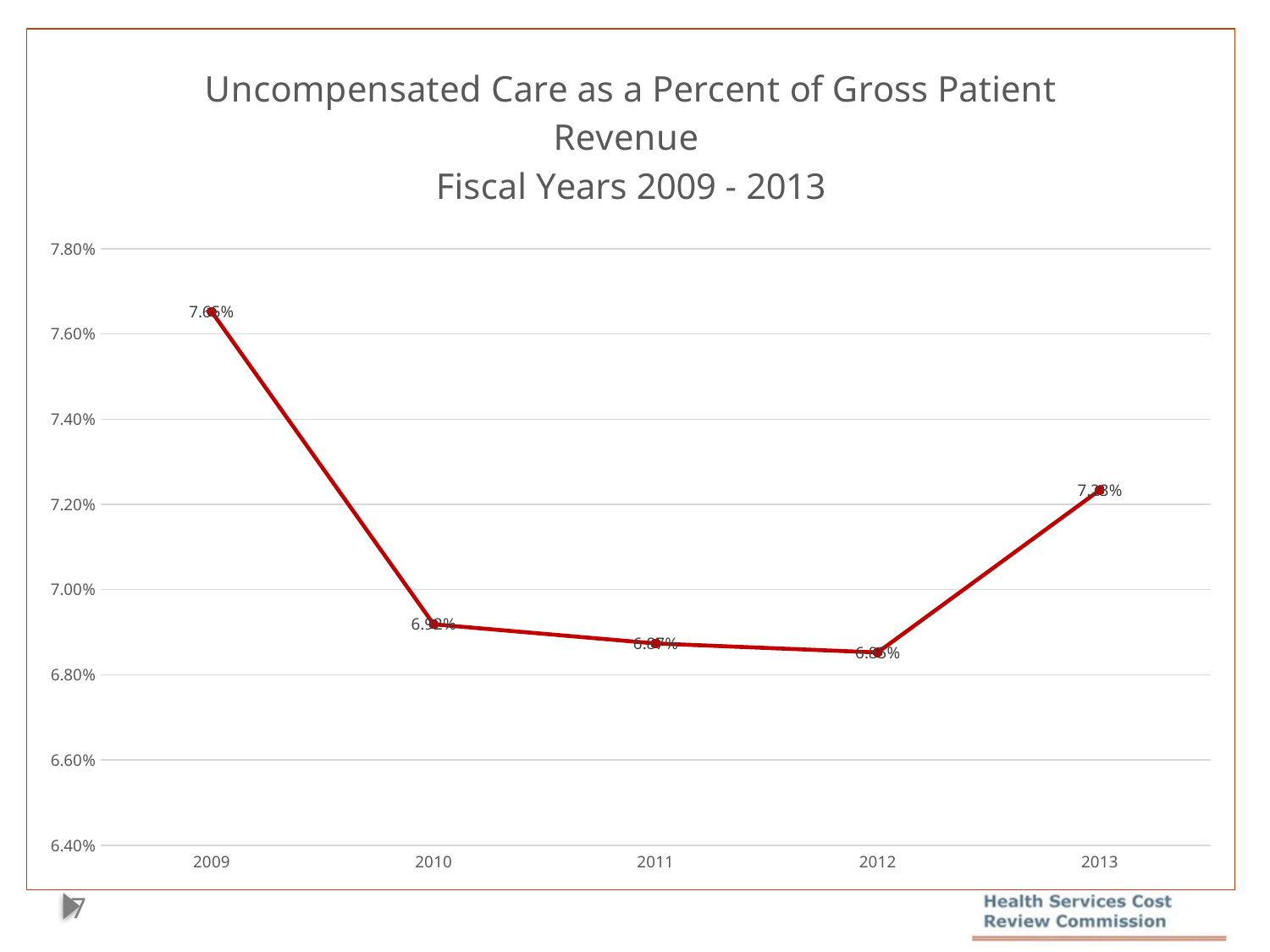
What is the uncompensated care percentage for fiscal year 2013? 7.23% What is the title of the chart? Uncompensated Care as a Percent of Gross Patient Revenue Fiscal Years 2009 - 2013 What is the uncompensated care percentage for fiscal year 2009? 7.65% How many fiscal years are plotted on the chart? 5 Which is larger, the value for 2009 or the value for 2013? 2009 What type of chart is shown on the slide? Line chart Does the uncompensated care percentage rise or fall from 2009 to 2010? Fall Is the value for 2013 greater or less than 7.00%? greater Which fiscal year has the highest uncompensated care percentage? 2009 Is the value for 2010 greater or less than 7.00%? less Is the value for 2012 greater or less than 6.80%? greater What is the difference between the 2009 value and the 2013 value? 0.42 percentage points